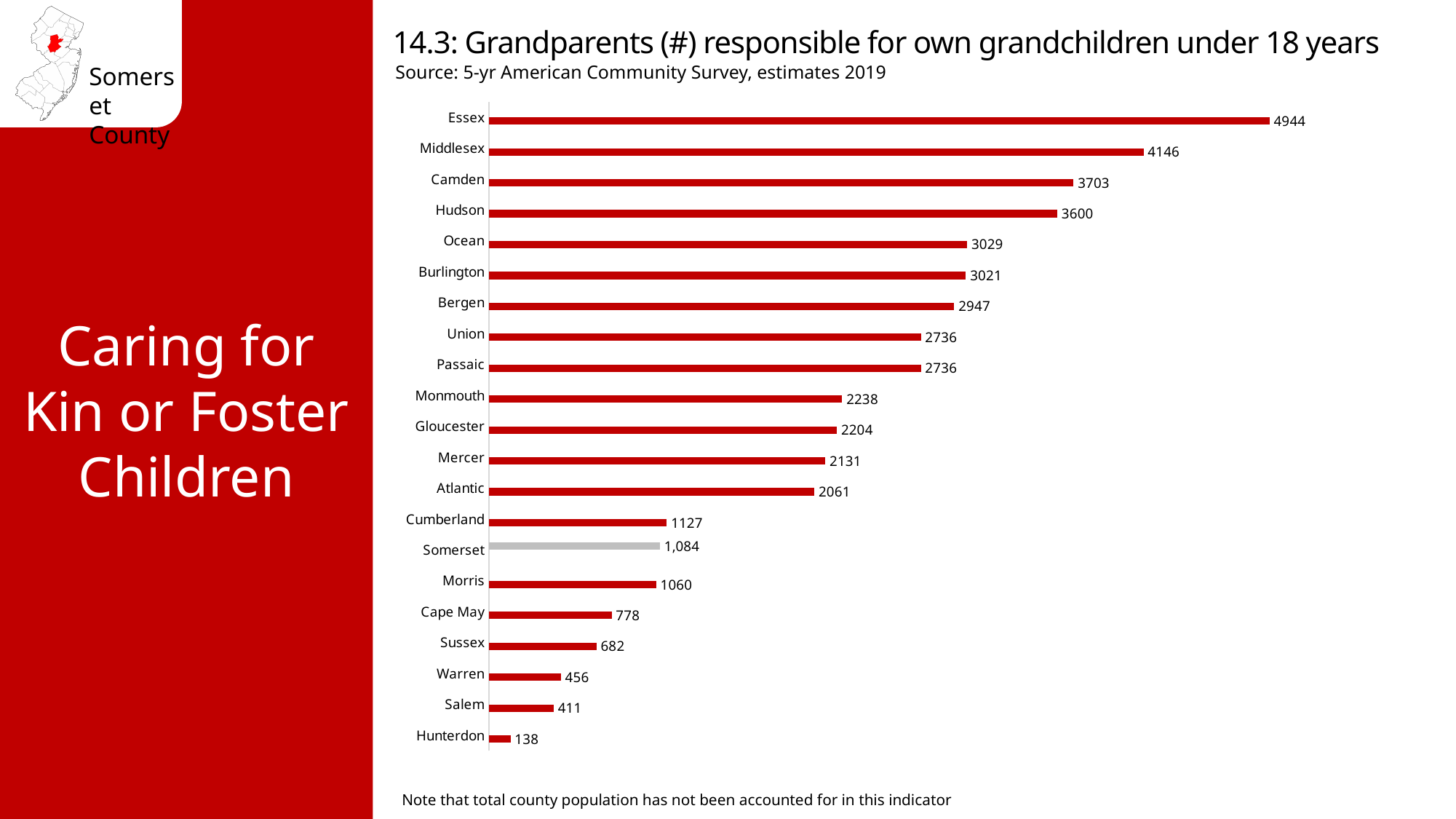
What is the value for Somerset? 1,084 What is the difference between the values for Essex and Middlesex? 798 Which county's bar is shown in grey rather than red? Somerset Which county has the lowest value? Hunterdon What is the difference between the values for Cumberland and Morris? 67 Which is larger, the value for Camden or the value for Ocean? Camden What kind of chart is shown on the slide? Bar chart Which is larger, the value for Warren or the value for Salem? Warren How many counties are shown in the chart? 21 Which county has the highest value? Essex What is the value for Essex? 4944 What is the value for Cape May? 778